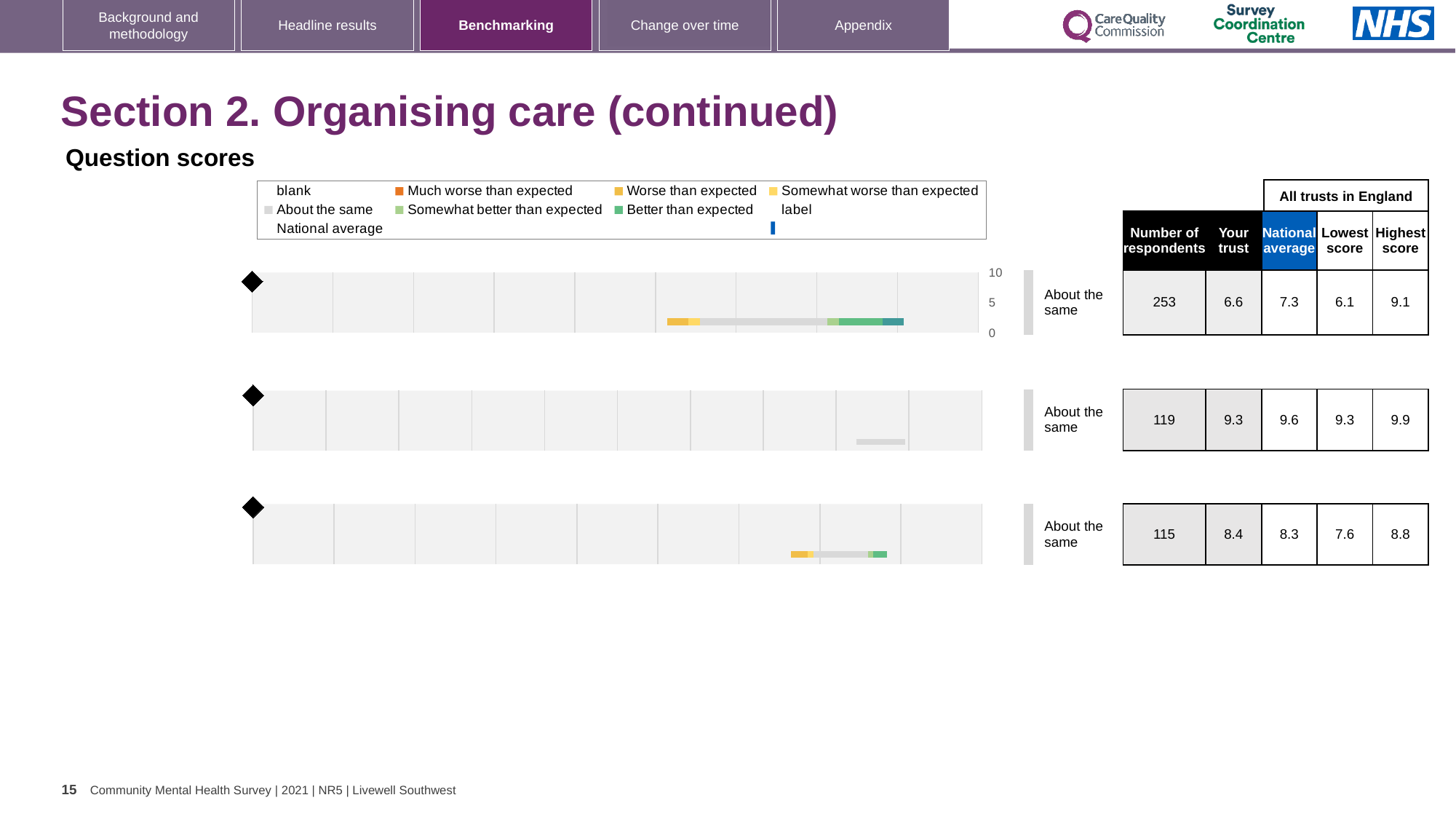
For the top chart, what is the 'Your trust' score shown in the table? 6.6 How many question score charts are shown on the slide? 3 For the middle chart, what is the difference between the highest score (9.9) and the lowest score (9.3)? 0.6 For the bottom chart, what is the highest score among all trusts in England? 8.8 Which of the three charts has the highest 'Your trust' score? The middle chart (9.3) For the top chart, what is the difference between the national average (7.3) and the 'Your trust' score (6.6)? 0.7 For the middle chart, what is the national average score? 9.6 For the top chart, how many respondents are listed in the table? 253 Which of the three charts has the lowest number of respondents? The bottom chart (115) What kind of chart is used to show the question scores on this slide? Bar chart For the bottom chart, which is larger: the 'Your trust' score or the national average? Your trust (8.4) What benchmark category label is shown next to each of the three charts? About the same